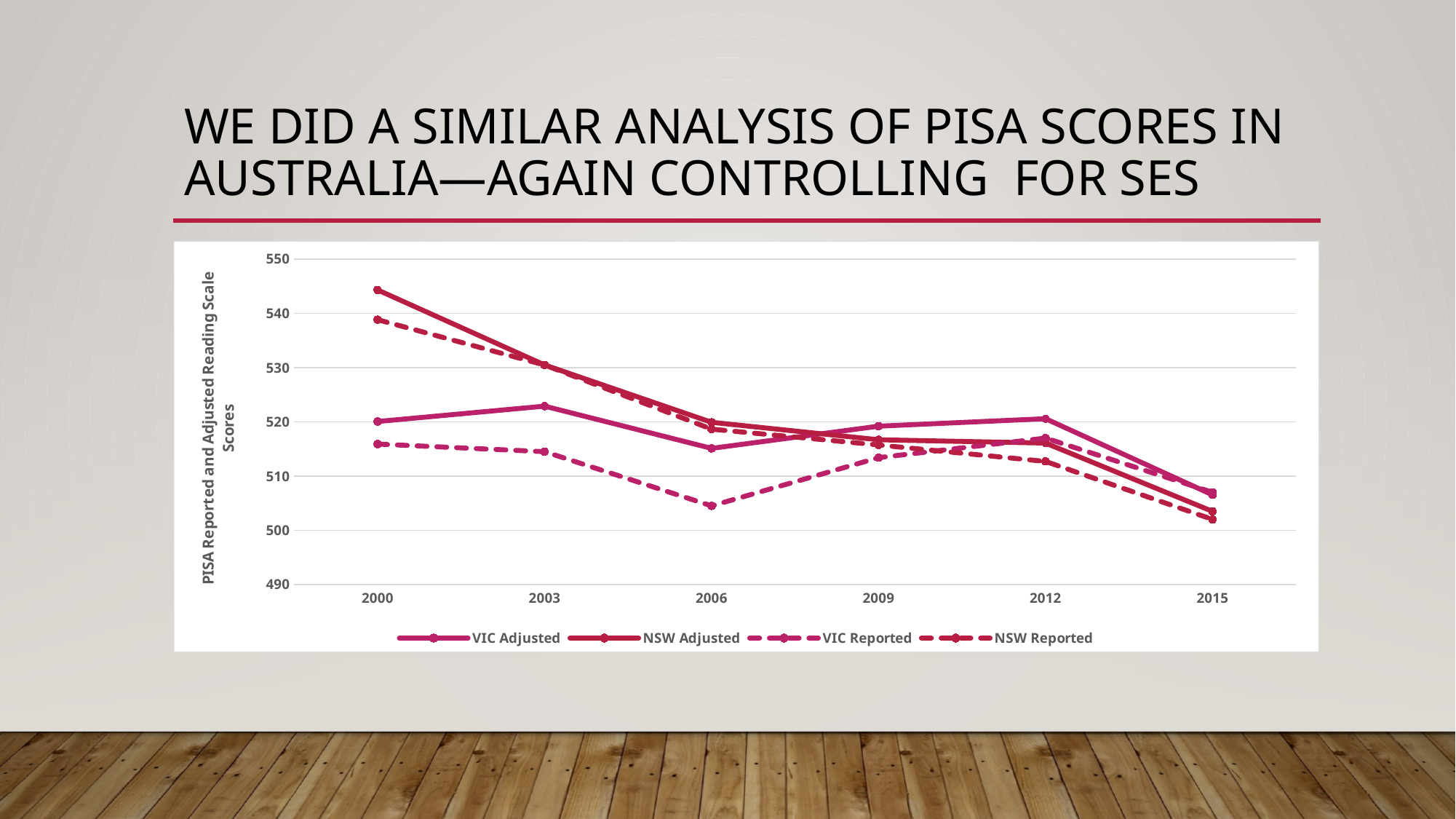
Is the value for VIC Reported in 2006 greater or less than 510? less What is the title of the vertical axis? PISA Reported and Adjusted Reading Scale Scores Is the value for VIC Adjusted in 2003 greater or less than 520? greater Is the value for NSW Adjusted in 2000 greater or less than 540? greater In which year is the NSW Adjusted score highest? 2000 Does the NSW Adjusted score rise or fall from 2000 to 2015? fall How many years are plotted along the x axis? 6 What kind of chart is shown on the slide? line chart How many series does the legend list? 4 In 2000, which is larger: NSW Adjusted or VIC Adjusted? NSW Adjusted In which year is the VIC Reported score lowest? 2006